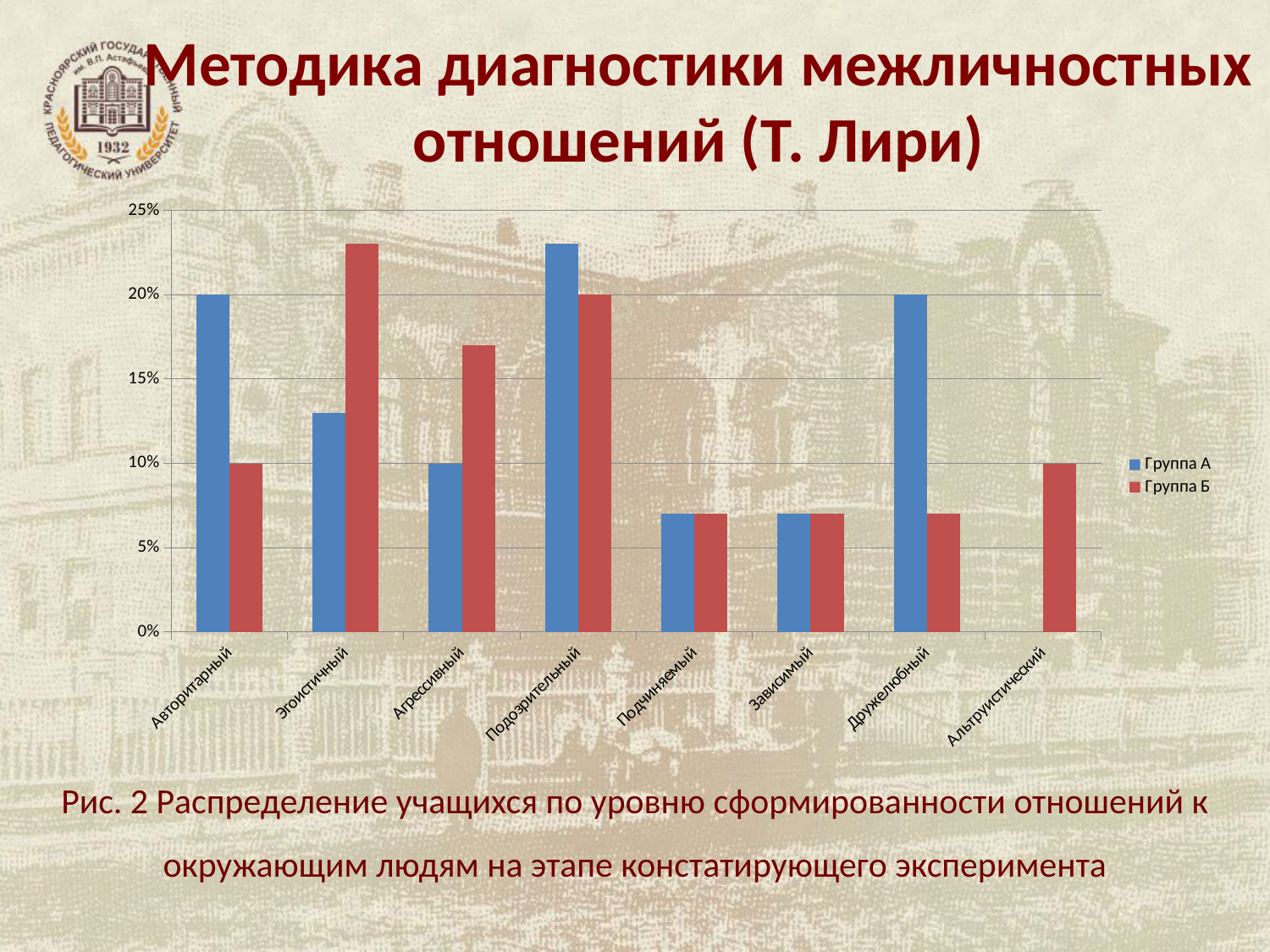
Is the value for Группа А in the Подчиняемый category greater or less than 10%? less In the Эгоистичный category, which group has the larger value? Группа Б Is the value for Группа Б in the Эгоистичный category greater or less than 20%? greater What is the difference between Группа А and Группа Б in the Авторитарный category? 10% What is the value for Группа Б in the Авторитарный category? 10% What type of chart is shown on the slide? bar chart How many categories are shown along the x axis? 8 In which category does Группа Б have its highest value? Эгоистичный How many series does the legend list? 2 What is the value for Группа А in the Авторитарный category? 20% In which category does Группа А have its highest value? Подозрительный What is the value for Группа Б in the Подозрительный category? 20%